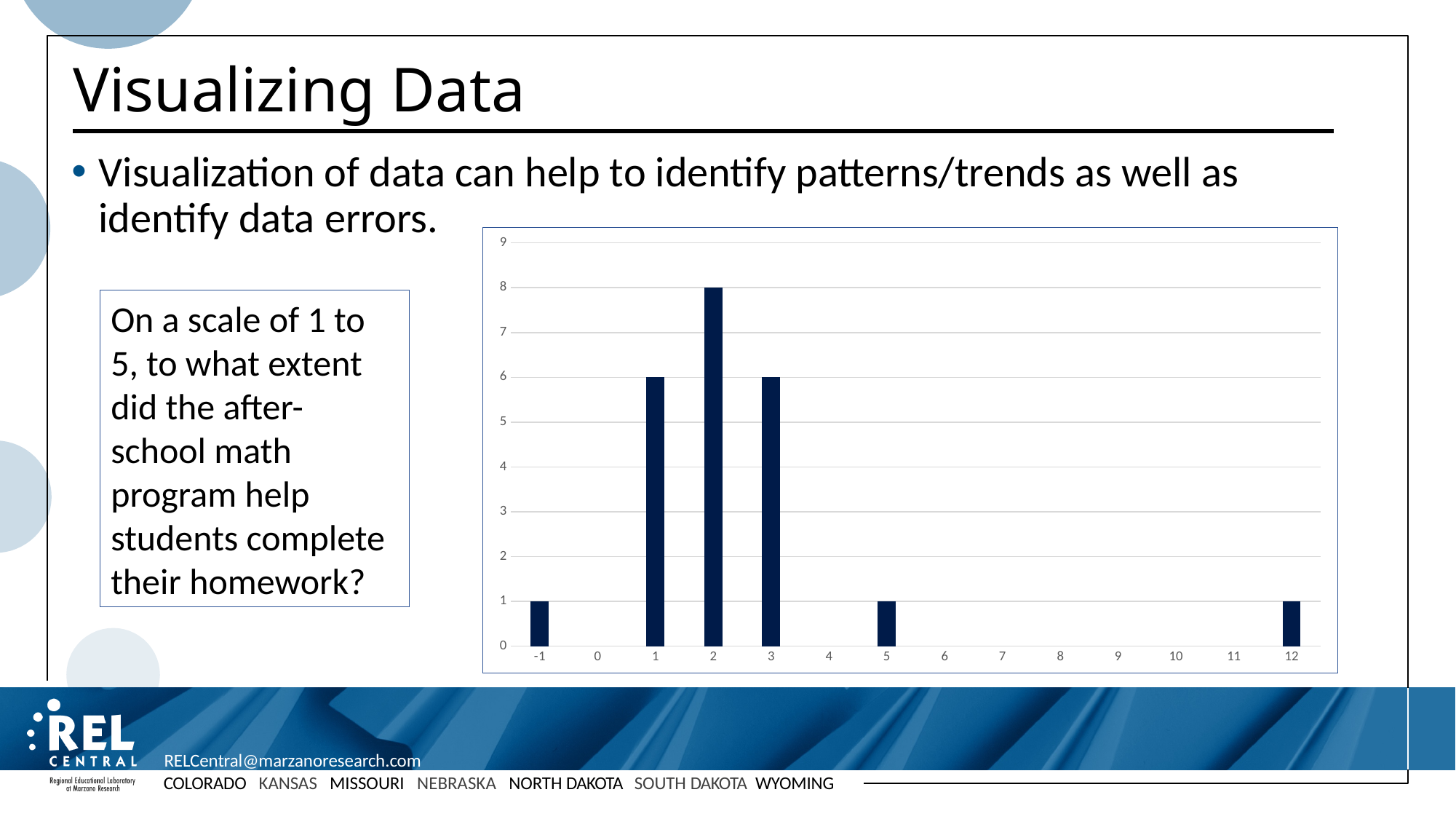
What is the value of the bar at category -1? 1 What is the value of the bar at category 12? 1 What is the difference between the bar at category 2 and the bar at category 1? 2 What kind of chart is shown on the slide? bar chart Which category has the highest bar? 2 What is the value of the bar at category 2? 8 How many categories have a bar with a value greater than 0? 6 How many categories are labelled on the x axis? 14 What is the value of the bar at category 1? 6 What is the highest value shown on the y axis? 9 Which is larger, the bar at category 2 or the bar at category 5? category 2 What is the value of the bar at category 3? 6